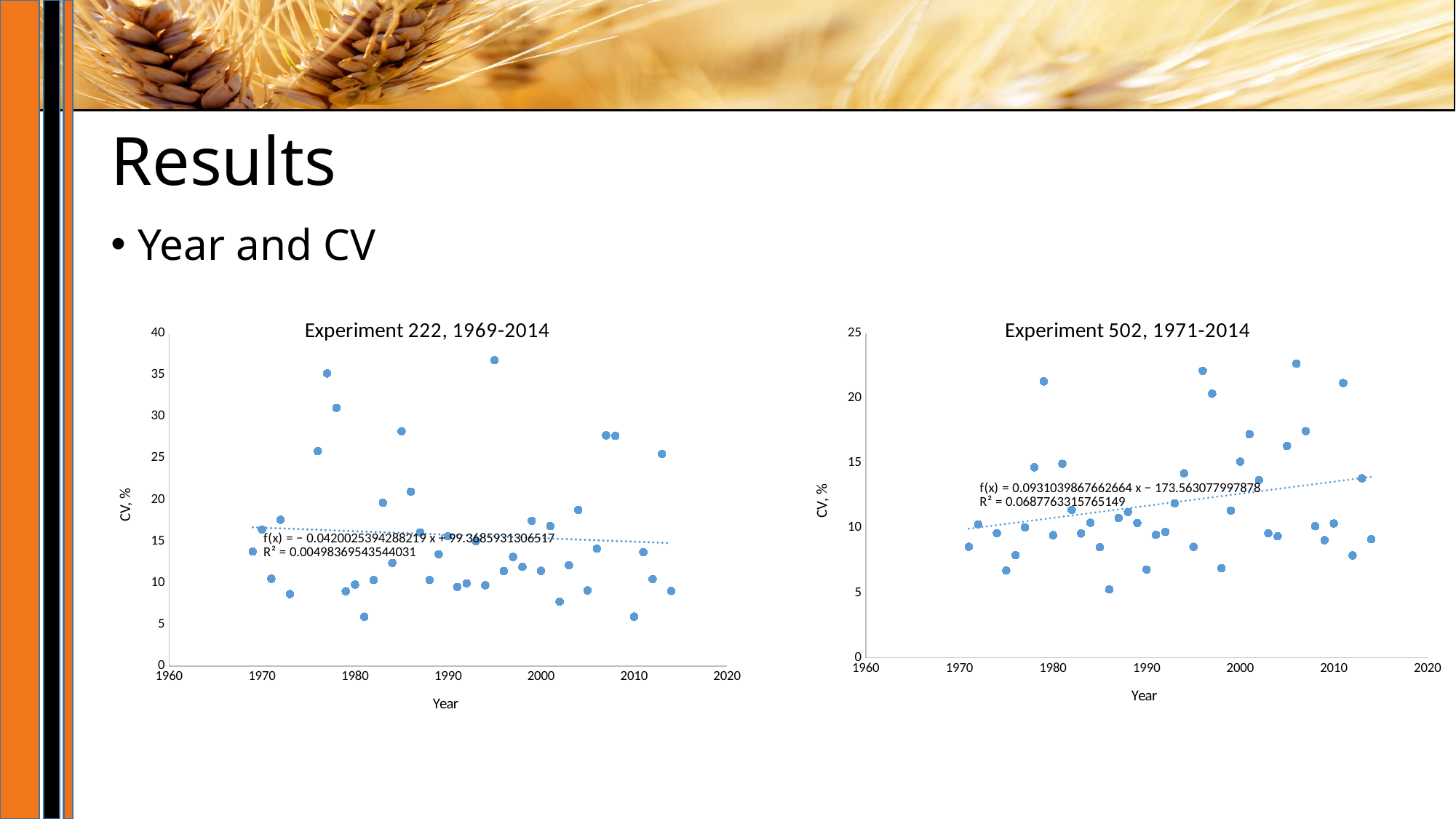
What is the R² value shown on the 'Experiment 222, 1969-2014' chart? 0.00498369543544031 What is the title of the chart on the left of the slide? Experiment 222, 1969-2014 What is the maximum value on the vertical axis of the 'Experiment 502, 1971-2014' chart? 25 What is the R² value shown on the 'Experiment 502, 1971-2014' chart? 0.0687763315765149 In the 'Experiment 222, 1969-2014' chart, is the highest CV value greater or less than 35? greater In the 'Experiment 222, 1969-2014' chart, is the lowest CV value greater or less than 10? less In the 'Experiment 502, 1971-2014' chart, is the lowest CV value greater or less than 10? less In the 'Experiment 502, 1971-2014' chart, does the fitted trendline rise or fall as the year increases? Rises In the 'Experiment 222, 1969-2014' chart, does the fitted trendline rise or fall as the year increases? Falls What is the label of the vertical axis on the 'Experiment 222, 1969-2014' chart? CV, % What kind of chart is the 'Experiment 222, 1969-2014' chart? Scatter chart